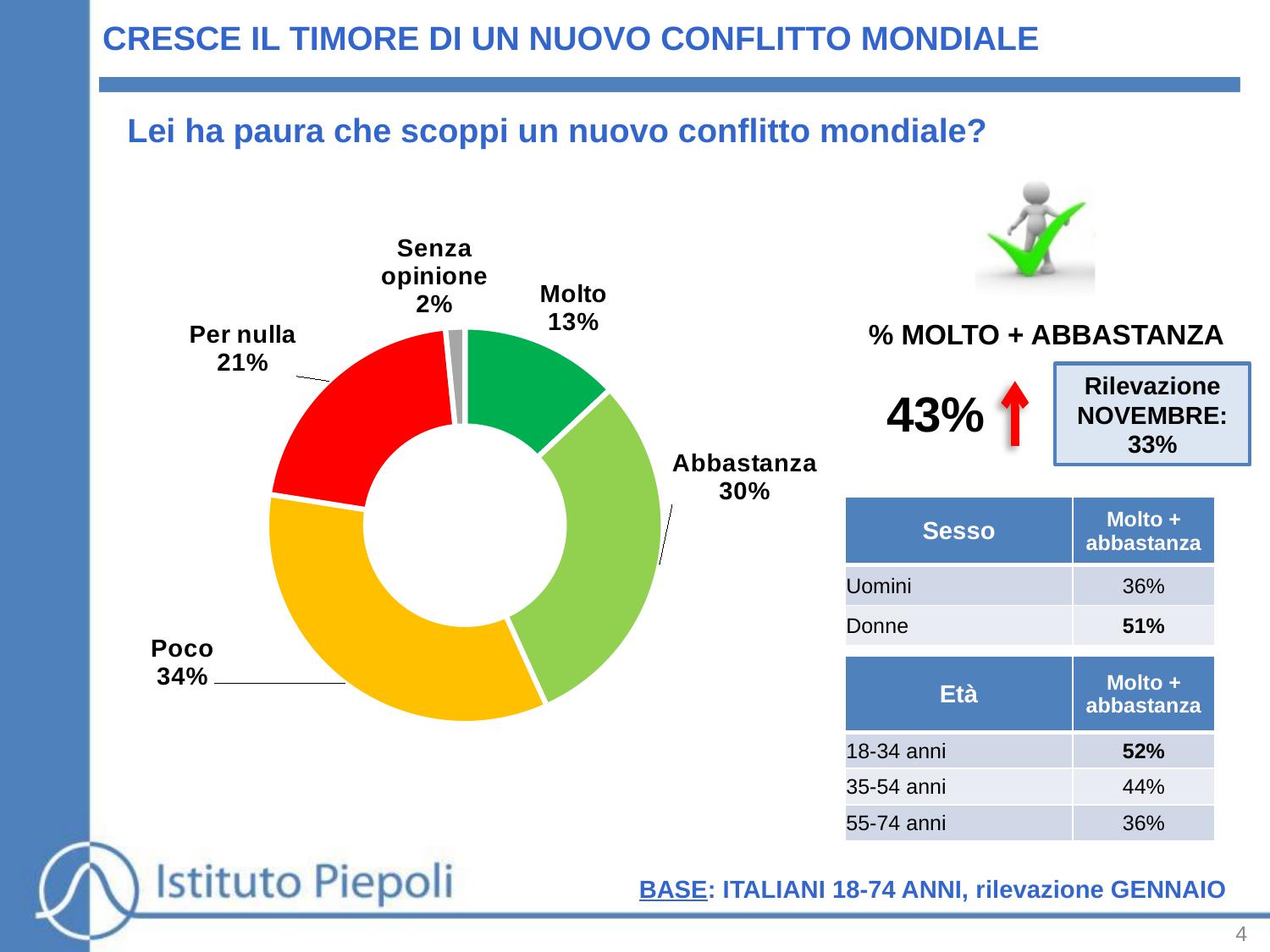
What percentage of respondents answered "Molto" in the doughnut chart? 13% What colour is the "Poco" segment of the doughnut chart? Yellow How many response categories are shown in the doughnut chart? 5 What is the difference in percentage points between "Abbastanza" and "Molto"? 17 What percentage of respondents answered "Poco" in the doughnut chart? 34% What type of chart is used to show the responses? Doughnut chart What percentage of respondents answered "Per nulla"? 21% What is the combined share of "Molto" and "Abbastanza" in the doughnut chart? 43% What colour is the "Per nulla" segment of the doughnut chart? Red Which response category has the largest share in the doughnut chart? Poco Which is larger, the share for "Per nulla" or the share for "Molto"? Per nulla Which response category has the smallest share in the doughnut chart? Senza opinione